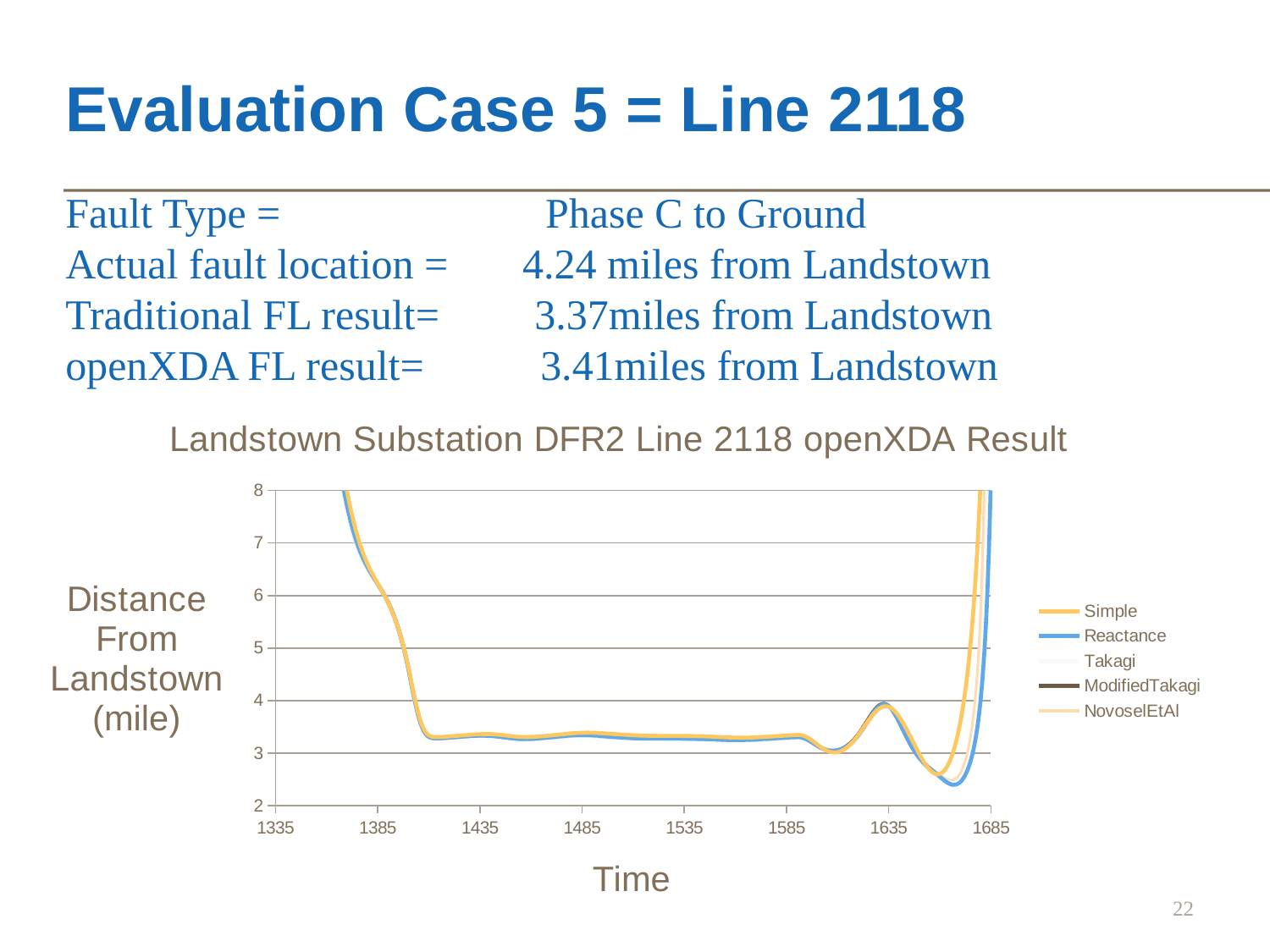
What is the label of the x axis of the chart? Time What kind of chart is shown on the slide? line chart Do the plotted values rise or fall as time approaches 1685 at the right end of the chart? rise Is the value of the Simple series at time 1485 greater or less than 4? less Is the value of the Reactance series at time 1385 greater or less than 5? greater What is the highest value shown on the y axis of the chart? 8 How many series does the legend of the chart list? 5 Do the plotted values rise or fall between time 1385 and time 1435? fall What is the title of the chart? Landstown Substation DFR2 Line 2118 openXDA Result Is the value of the Simple series at time 1485 greater or less than 3? greater